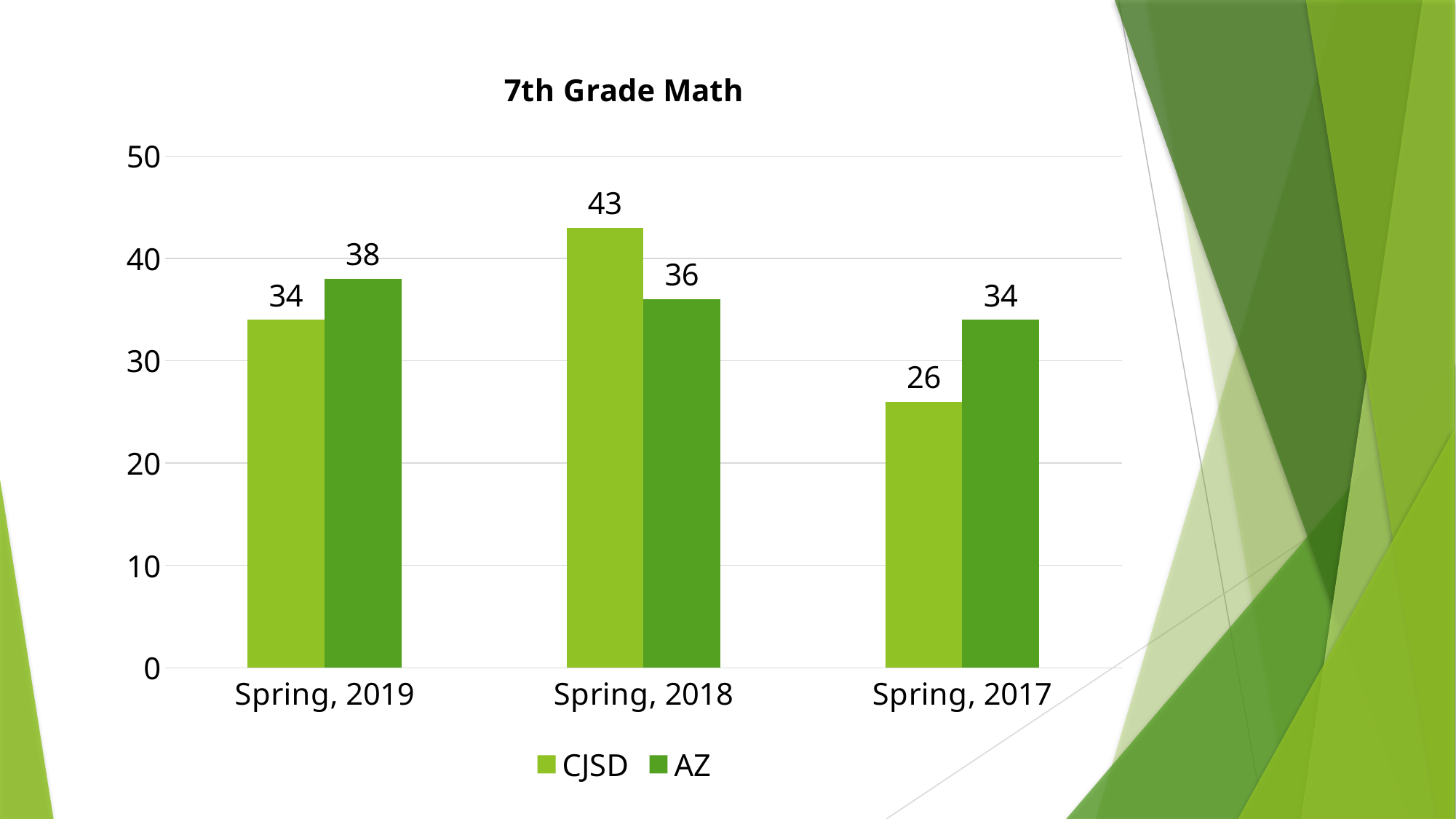
What kind of chart is shown? bar chart Is the AZ value for Spring, 2019 greater or less than 30? greater Which category has the lowest AZ value? Spring, 2017 How many categories are shown on the x axis? 3 What is the CJSD value for Spring, 2017? 26 What is the AZ value for Spring, 2018? 36 Which is larger for Spring, 2018, CJSD or AZ? CJSD What is the CJSD value for Spring, 2019? 34 What is the difference between the CJSD and AZ values for Spring, 2017? 8 Which category has the highest CJSD value? Spring, 2018 How many series does the legend list? 2 What is the title of the chart? 7th Grade Math